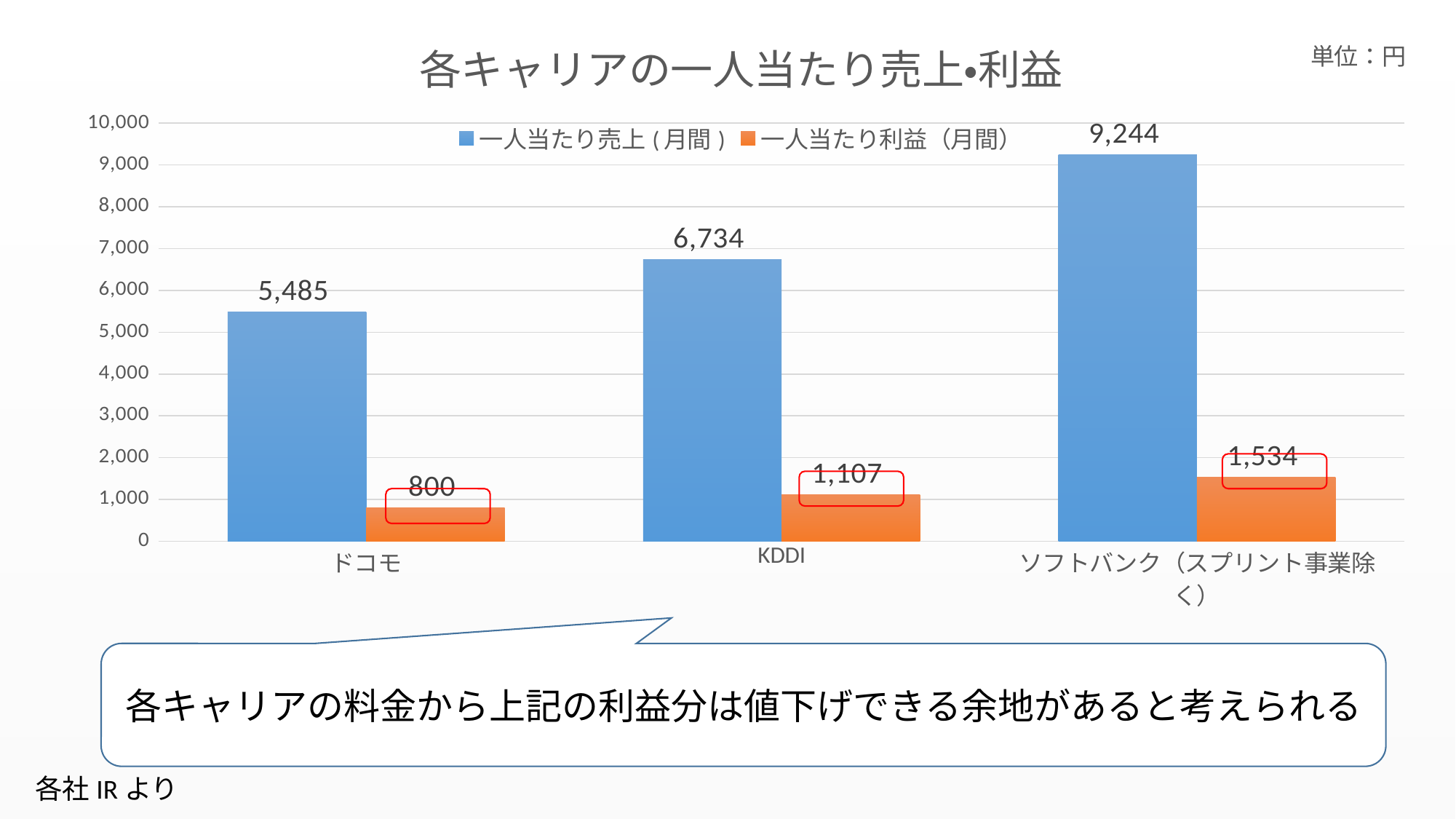
How many carriers are shown on the x axis? 3 Which is larger, the 一人当たり利益(月間) of KDDI or of ドコモ? KDDI Which carrier has the highest 一人当たり売上(月間)? ソフトバンク（スプリント事業除く） What is the 一人当たり利益(月間) value for ドコモ? 800 What is the 一人当たり売上(月間) value for ソフトバンク（スプリント事業除く）? 9,244 What is the 一人当たり売上(月間) value for ドコモ? 5,485 What is the difference between the 一人当たり売上(月間) of KDDI and ドコモ? 1,249 How many series does the legend list? 2 What is the 一人当たり利益(月間) value for KDDI? 1,107 Which carrier has the lowest 一人当たり利益(月間)? ドコモ What kind of chart is shown on the slide? Bar chart What is the difference between the 一人当たり利益(月間) of ソフトバンク（スプリント事業除く） and KDDI? 427